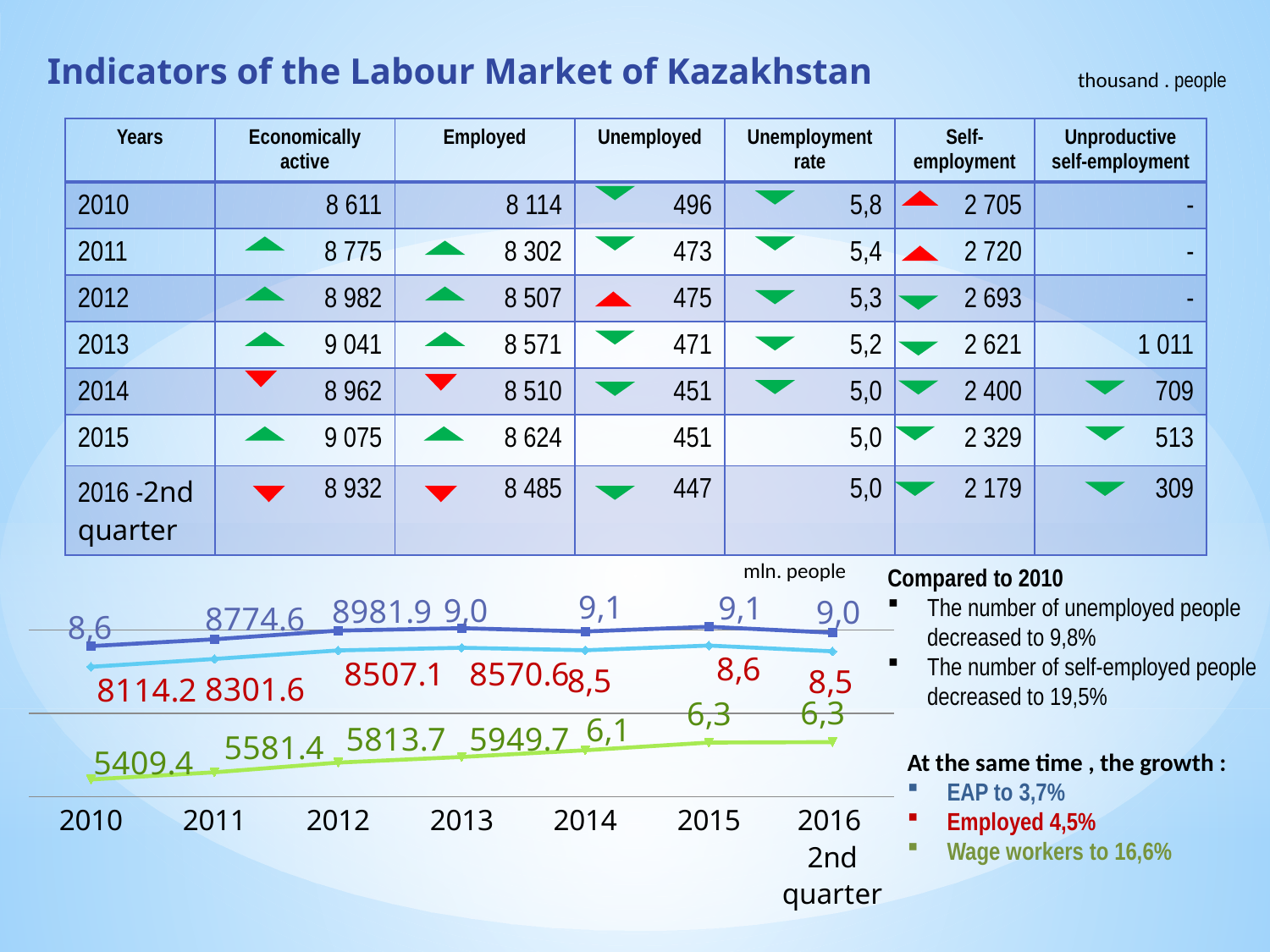
How many time points are plotted along the x axis of the line chart? 7 In the line chart, what is the data label on the top (dark blue) line for 2014? 9,1 In the line chart, what is the data label on the middle (light blue) line for 2013? 8570.6 In the line chart, what is the data label on the top (dark blue) line for 2011? 8774.6 How many lines are plotted in the line chart? 3 In the line chart, what is the difference between the bottom (green) line's labels for 2013 (5949.7) and 2012 (5813.7)? 136 What type of chart is shown at the bottom of the slide? line chart In the line chart, what is the data label on the bottom (green) line for 2012? 5813.7 In the line chart, what is the data label on the bottom (green) line for 2010? 5409.4 In the line chart, which year has the lowest value on the bottom (green) line? 2010 What unit label is printed above the line chart? mln. people In the line chart, does the bottom (green) line rise or fall from 2010 to 2016 2nd quarter? rise